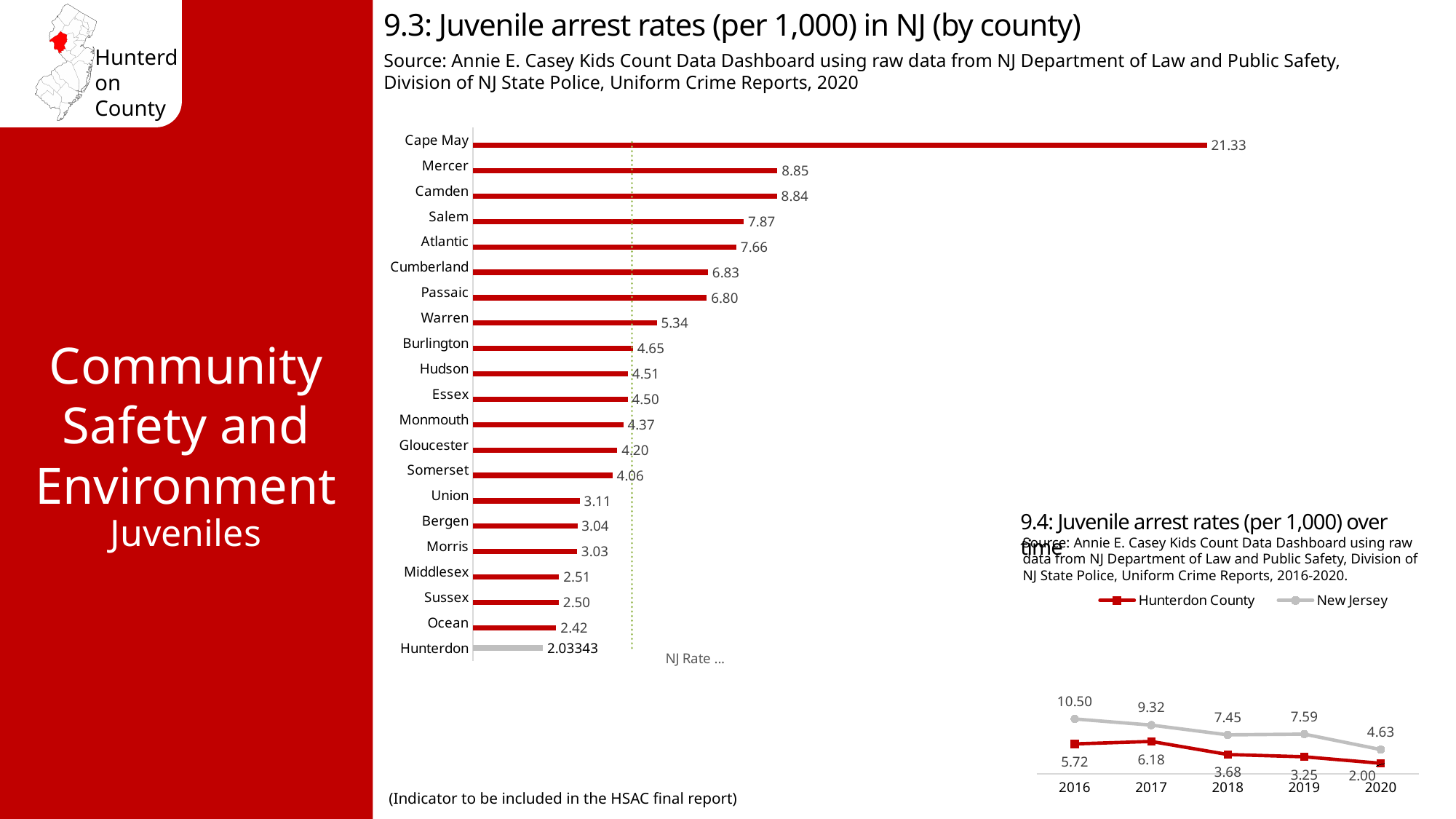
In the chart '9.3: Juvenile arrest rates (per 1,000) in NJ (by county)', which county has the highest rate? Cape May How many counties are shown in the chart '9.3: Juvenile arrest rates (per 1,000) in NJ (by county)'? 21 In the chart '9.3: Juvenile arrest rates (per 1,000) in NJ (by county)', what is the difference between Cape May and Mercer? 12.48 What kind of chart is '9.3: Juvenile arrest rates (per 1,000) in NJ (by county)'? Bar chart In the chart '9.3: Juvenile arrest rates (per 1,000) in NJ (by county)', which has a higher rate, Warren or Burlington? Warren In the chart '9.3: Juvenile arrest rates (per 1,000) in NJ (by county)', what is the value for Cape May? 21.33 How many series does the legend list in the chart '9.4: Juvenile arrest rates (per 1,000) over time'? 2 In the chart '9.4: Juvenile arrest rates (per 1,000) over time', what is the difference between the New Jersey and Hunterdon County values in 2016? 4.78 In the chart '9.3: Juvenile arrest rates (per 1,000) in NJ (by county)', which county has the lowest rate? Hunterdon In the chart '9.4: Juvenile arrest rates (per 1,000) over time', what is the Hunterdon County value for 2020? 2.00 In the chart '9.3: Juvenile arrest rates (per 1,000) in NJ (by county)', what is the value for Hunterdon? 2.03343 In the chart '9.4: Juvenile arrest rates (per 1,000) over time', what is the New Jersey value for 2016? 10.50